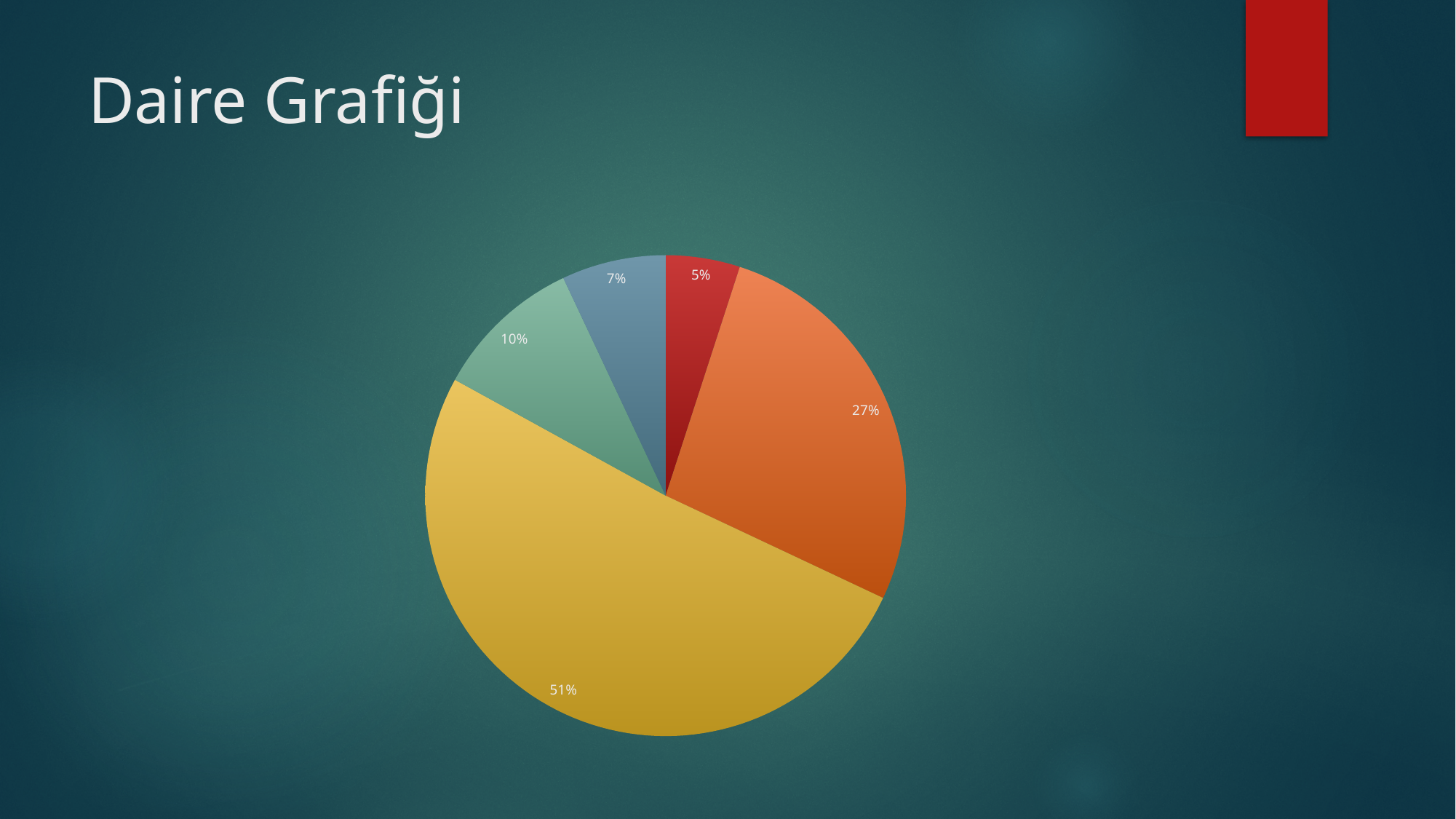
How many slices does the pie chart have? 5 What percentage is shown on the green slice of the pie chart? 10% What percentage is shown on the blue slice of the pie chart? 7% What percentage is shown on the red slice of the pie chart? 5% Which slice of the pie chart is the smallest? the red slice (5%) What is the slide title? Daire Grafiği What is the difference between the yellow slice and the orange slice in the pie chart? 24% Which is larger in the pie chart, the green slice or the blue slice? the green slice What percentage is shown on the yellow slice of the pie chart? 51% What percentage is shown on the orange slice of the pie chart? 27% Which slice of the pie chart is the largest? the yellow slice (51%) What kind of chart is shown on the slide? pie chart